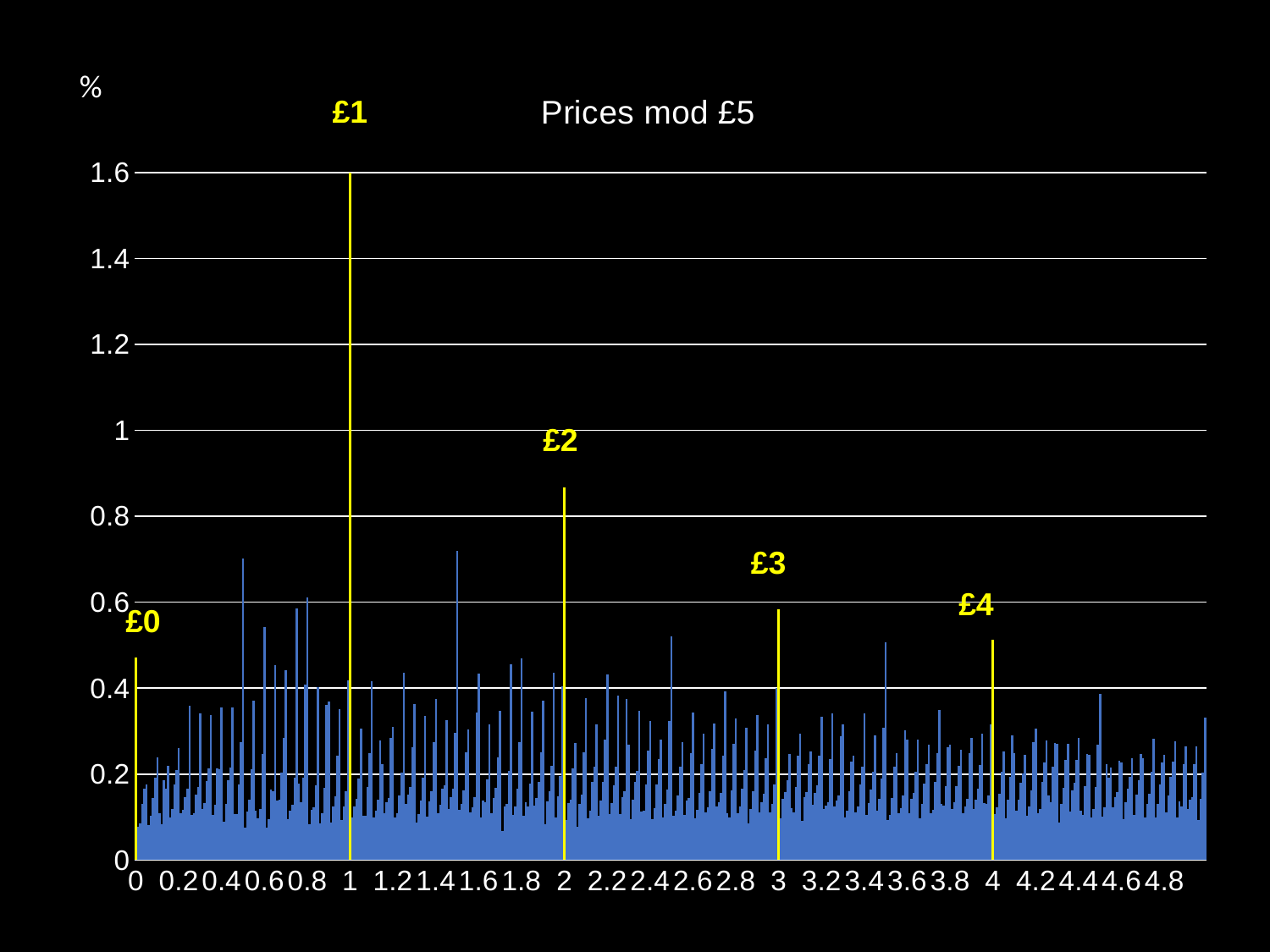
Is the value for the £2 bar greater or less than 0.8? greater How many bars are highlighted in yellow with pound labels? 5 Is the value for the £1 bar greater or less than 1.4? greater Which highlighted price has the highest bar in the chart? £1 What is the title of the chart? Prices mod £5 Is the value for the £3 bar greater or less than 0.4? greater What kind of chart is shown on the slide? bar chart Which is larger, the bar for £2 or the bar for £3? £2 Which is larger, the bar for £3 or the bar for £4? £3 Which is larger, the bar for £1 or the bar for £2? £1